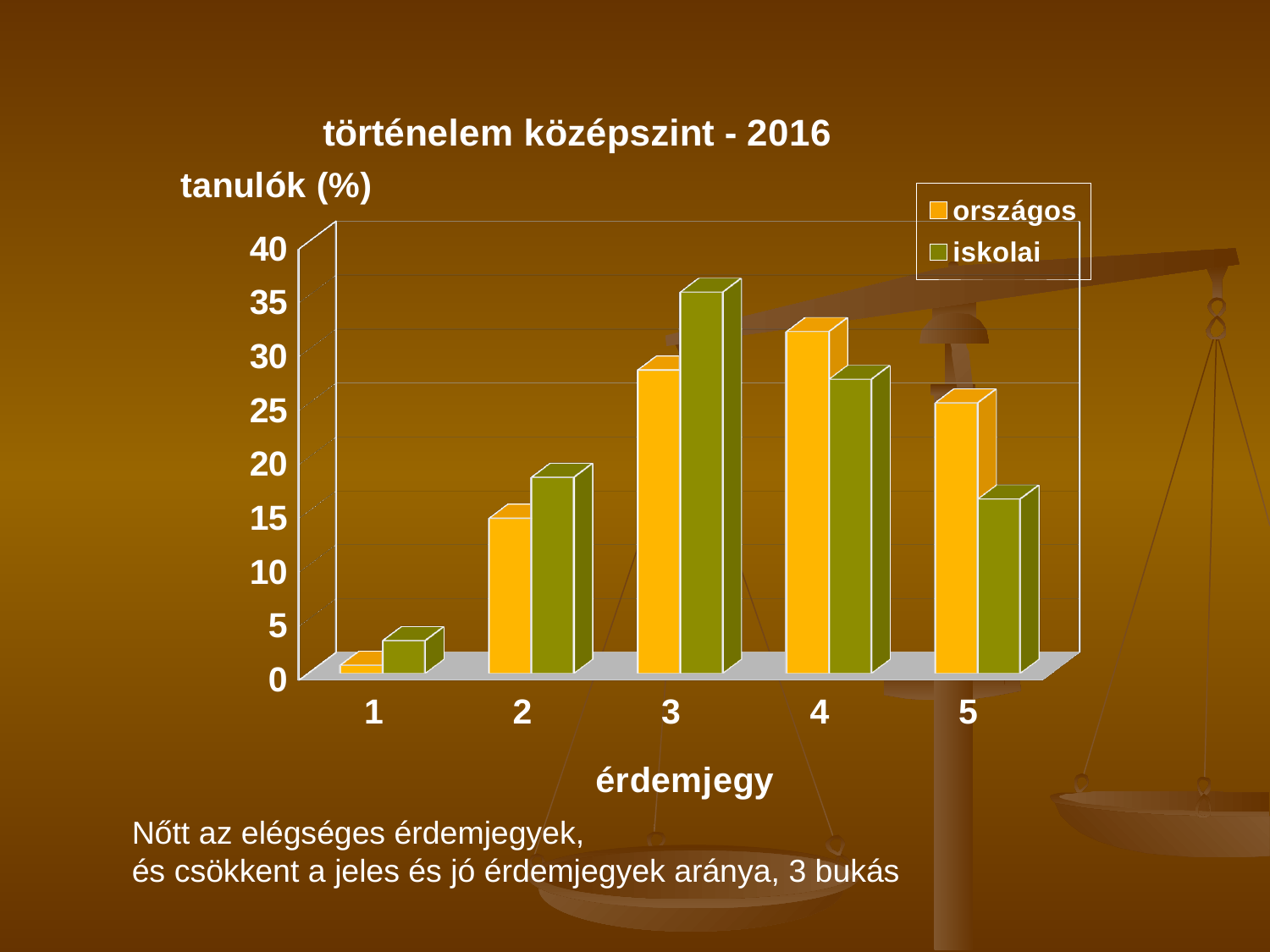
Is the országos value for grade 1 greater or less than 5? less For grade 5, which series has the larger value, országos or iskolai? országos For which grade is the iskolai value highest? 3 For which grade is the országos value highest? 4 How many series does the legend list? 2 For grade 3, which series has the larger value, országos or iskolai? iskolai What are the two series named in the legend? országos, iskolai Is the iskolai value for grade 3 greater or less than 30? greater What kind of chart is shown on the slide? bar chart For which grade is the országos value lowest? 1 How many grade categories (érdemjegy) are shown on the x axis? 5 What is the title of the chart? történelem középszint - 2016